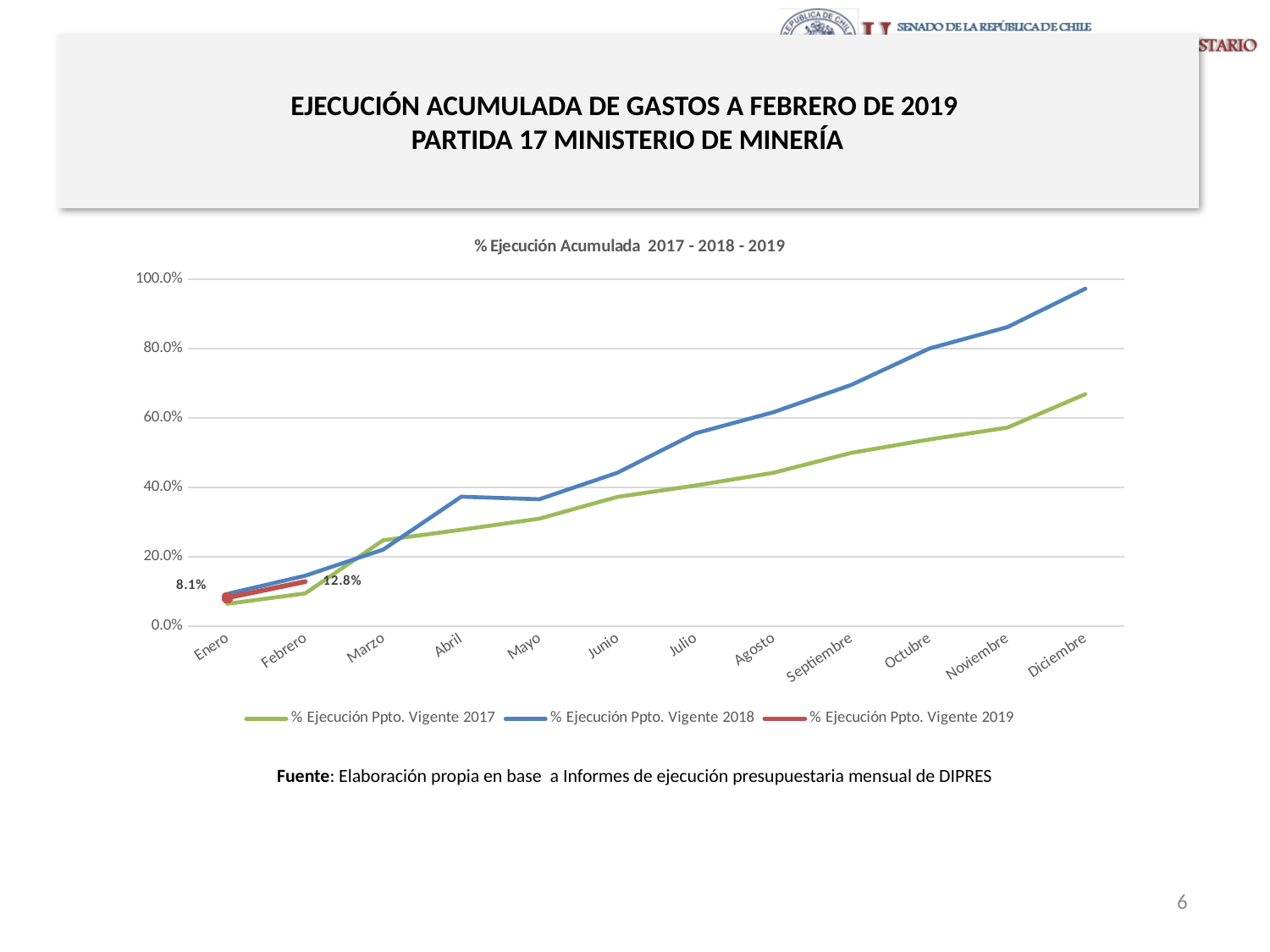
What is the value for % Ejecución Ppto. Vigente 2019 in Enero? 8.1% In which month does the % Ejecución Ppto. Vigente 2018 line reach its highest value? Diciembre By how many percentage points did % Ejecución Ppto. Vigente 2019 increase from Enero to Febrero? 4.7 percentage points What kind of chart is shown on the slide? Line chart How many months are shown on the x axis of the chart? 12 What is the title of the chart? % Ejecución Acumulada 2017 - 2018 - 2019 What is the value for % Ejecución Ppto. Vigente 2019 in Febrero? 12.8% In Diciembre, which series has the higher value: % Ejecución Ppto. Vigente 2017 or % Ejecución Ppto. Vigente 2018? % Ejecución Ppto. Vigente 2018 Is the value for % Ejecución Ppto. Vigente 2018 in Diciembre greater or less than 80%? greater Is the value for % Ejecución Ppto. Vigente 2017 in Diciembre greater or less than 80%? less How many series does the legend list? 3 Does the % Ejecución Ppto. Vigente 2018 line generally rise or fall from Enero to Diciembre? Rise